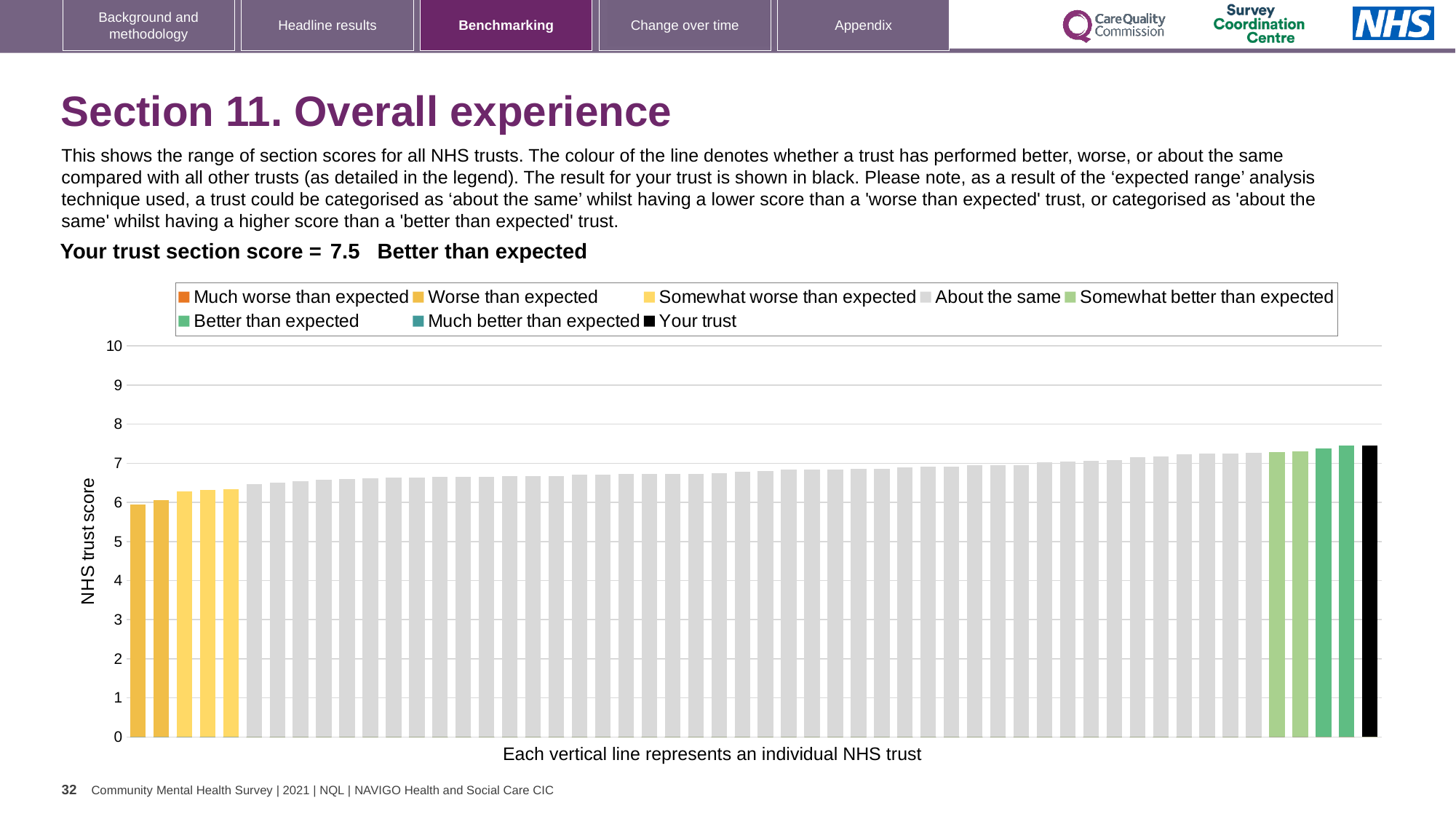
What kind of chart is shown on the slide? bar chart Is the value for the leftmost bar in the chart greater or less than 7? less Is the value for the tallest bar in the chart greater or less than 8? less Which performance category is your trust assigned for Section 11 Overall experience? Better than expected Is the value for the black 'Your trust' bar greater or less than 7? greater Do the bar values rise or fall from left to right along the x axis? rise What is the label on the vertical axis of the chart? NHS trust score What is the section score for your trust shown on the slide? 7.5 How many entries does the chart legend list? 8 Is the value for the black 'Your trust' bar greater or less than the value for the leftmost bar? greater What colour is the bar representing your trust? black